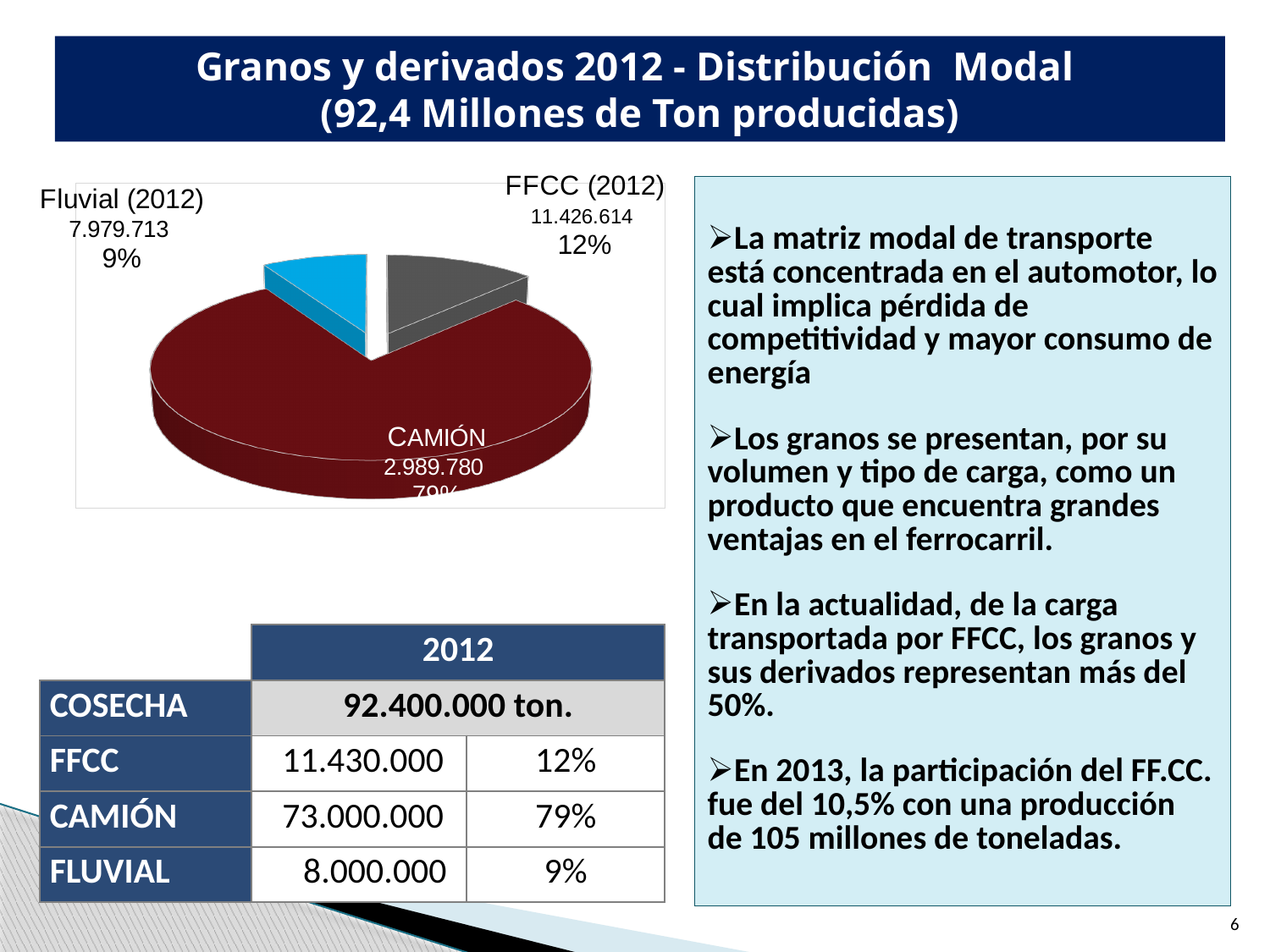
What value is labelled on the Fluvial (2012) slice of the pie chart? 7.979.713 What colour is the Fluvial (2012) slice in the pie chart? blue What share of the pie does the Fluvial (2012) slice represent? 9% What colour is the CAMIÓN slice in the pie chart? dark red Which slice is larger in the pie chart, FFCC (2012) or Fluvial (2012)? FFCC (2012) What share of the pie does the FFCC (2012) slice represent? 12% Which slice of the pie chart is the largest? CAMIÓN What value is labelled on the FFCC (2012) slice of the pie chart? 11.426.614 By how many percentage points does the FFCC (2012) share exceed the Fluvial (2012) share in the pie chart? 3% How many slices does the pie chart have? 3 What kind of chart is shown on the slide? pie chart Which slice of the pie chart is the smallest? Fluvial (2012)